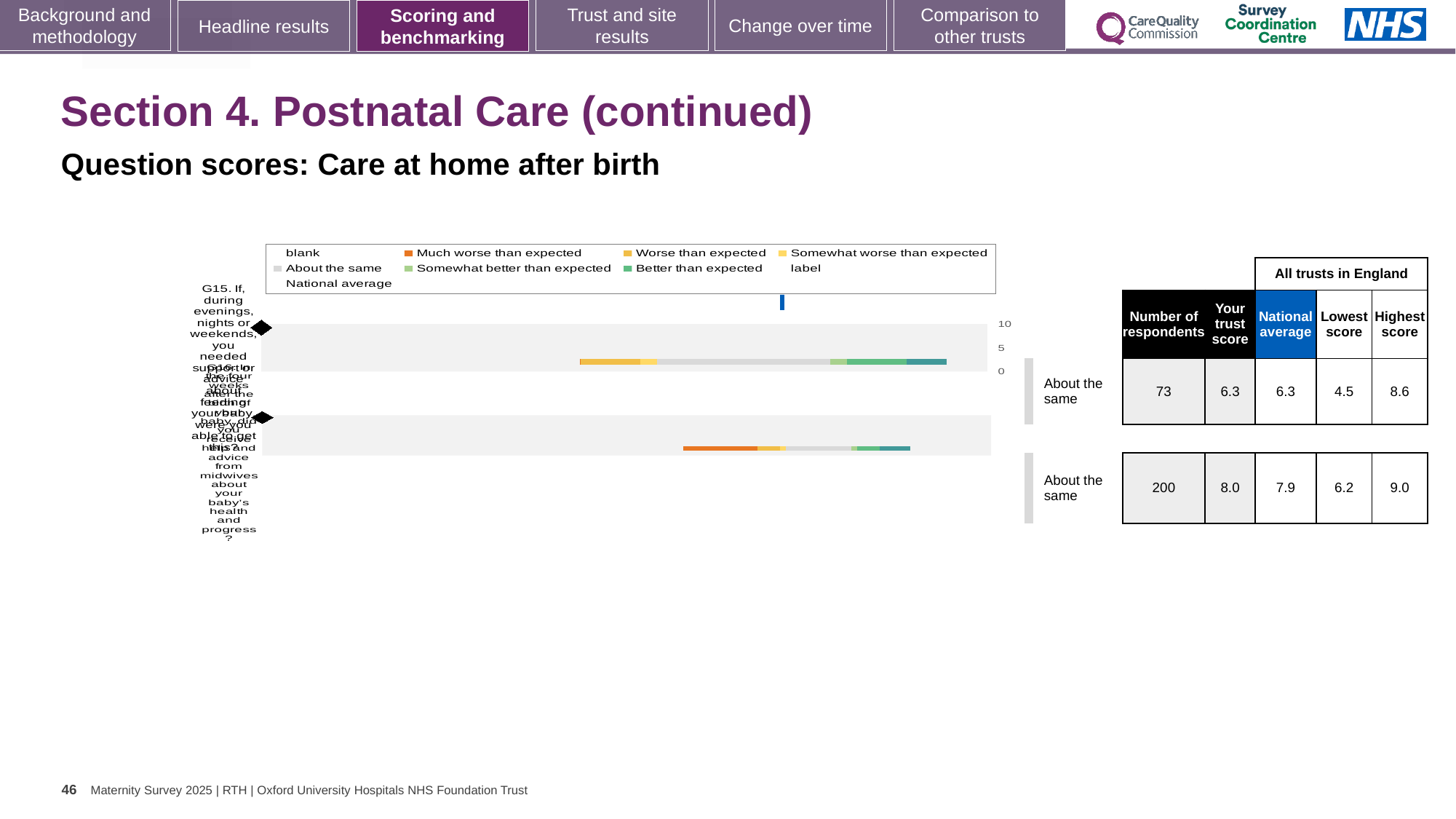
In the chart legend, which category is shown in grey? About the same In the table beside the chart, what is the national average for the second question (G16)? 7.9 What benchmark category is shown for both questions in the chart? About the same How many question bars are plotted in the chart? 2 In the table beside the chart, what is the highest score in England for the first question (G15)? 8.6 In the chart legend, what colour is used for 'Much worse than expected'? orange In the table beside the chart, what is the trust score for the second question (G16)? 8.0 In the table beside the chart, which question has the higher trust score, the first (G15) or the second (G16)? the second (G16) In the table beside the chart, what is the number of respondents for the first question (G15)? 73 What kind of chart is shown on the slide? bar chart In the table beside the chart, what is the lowest score in England for the second question (G16)? 6.2 In the table beside the chart, what is the difference between the highest and lowest scores for the first question (G15)? 4.1